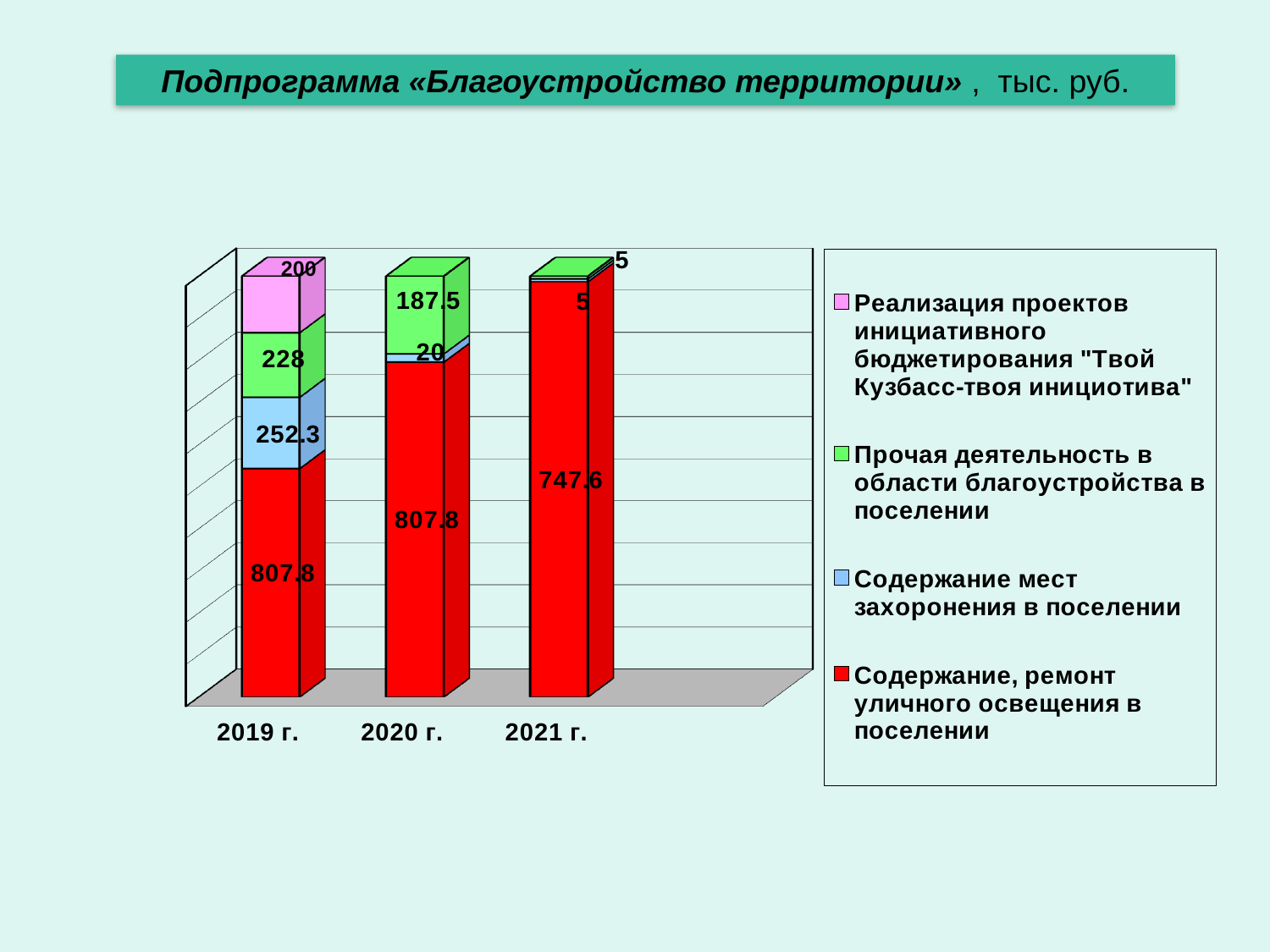
What is the value for "Содержание, ремонт уличного освещения в поселении" in 2021 г.? 747.6 What type of chart is shown on the slide? Stacked bar chart What is the value for "Реализация проектов инициативного бюджетирования" in 2019 г.? 200 What is the total of the stacked bar for 2019 г.? 1488.1 What is the value for "Прочая деятельность в области благоустройства в поселении" in 2020 г.? 187.5 What is the value for "Содержание мест захоронения в поселении" in 2019 г.? 252.3 How many series does the legend list? 4 Does the total of the stacked bars rise or fall from 2019 г. to 2021 г.? Fall What is the difference between the "Прочая деятельность в области благоустройства в поселении" values for 2019 г. and 2020 г.? 40.5 Which year has the highest total stacked bar? 2019 г. What is the total of the stacked bar for 2021 г.? 757.6 How many years (categories) are shown on the x axis? 3